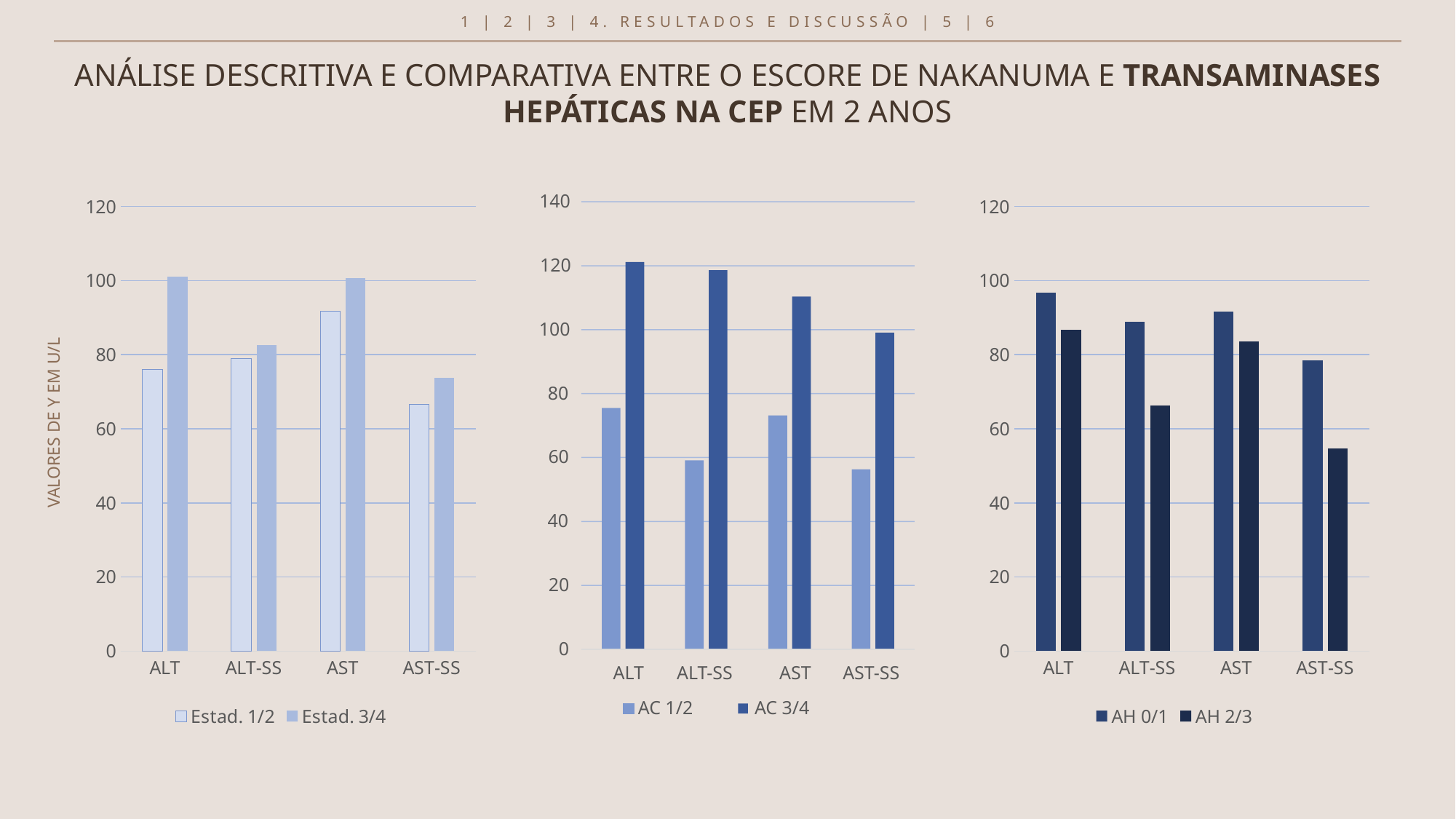
In the middle chart, which series has the larger value for ALT-SS, AC 1/2 or AC 3/4? AC 3/4 In the middle chart, which category has the highest value for AC 3/4? ALT In the middle chart, is the value of AC 1/2 for AST-SS greater or less than 60? less How many categories are shown on the x axis of the right chart? 4 What kind of chart is the left chart with the legend 'Estad. 1/2' and 'Estad. 3/4'? bar chart In the right chart, is the value of AH 2/3 for AST-SS greater or less than 60? less How many series does the legend of the middle chart list? 2 In the right chart, which category has the lowest value for AH 2/3? AST-SS What is the y-axis label of the left chart? VALORES DE Y EM U/L In the middle chart, is the value of AC 3/4 for ALT greater or less than 100? greater In the right chart, do the values of AH 0/1 rise or fall from AST to AST-SS? fall